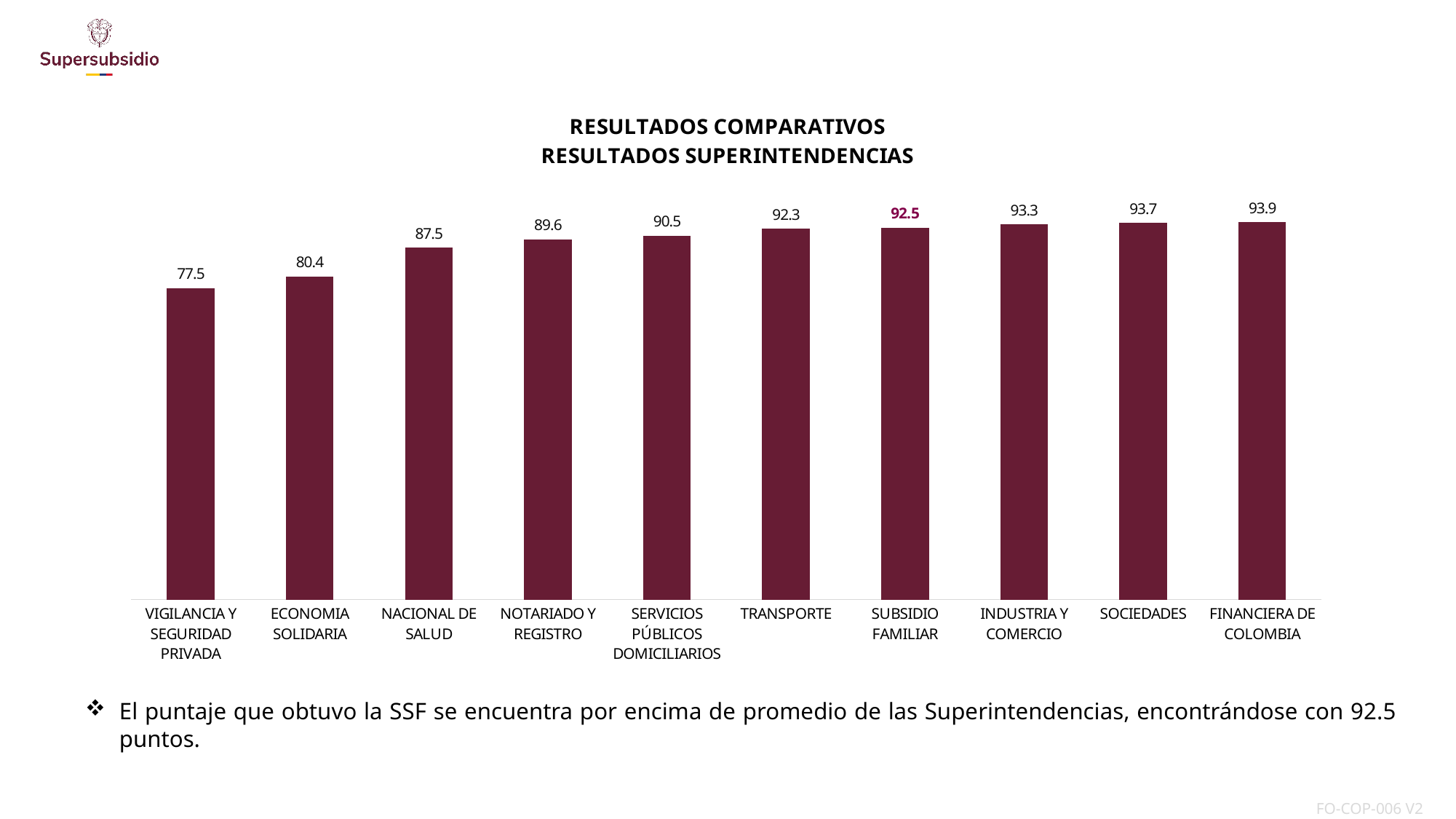
Which category has the lowest value? VIGILANCIA Y SEGURIDAD PRIVADA What is the value for NOTARIADO Y REGISTRO? 89.6 How many categories are shown in the chart? 10 What is the difference between the values for SUBSIDIO FAMILIAR and TRANSPORTE? 0.2 What is the difference between the values for FINANCIERA DE COLOMBIA and VIGILANCIA Y SEGURIDAD PRIVADA? 16.4 What is the title of the chart? RESULTADOS COMPARATIVOS RESULTADOS SUPERINTENDENCIAS Do the values rise or fall from left to right along the x axis? Rise Which is larger, the value for NACIONAL DE SALUD or the value for ECONOMIA SOLIDARIA? NACIONAL DE SALUD What is the value for SUBSIDIO FAMILIAR? 92.5 What kind of chart is shown on the slide? Bar chart Which category has the highest value? FINANCIERA DE COLOMBIA What is the value for VIGILANCIA Y SEGURIDAD PRIVADA? 77.5